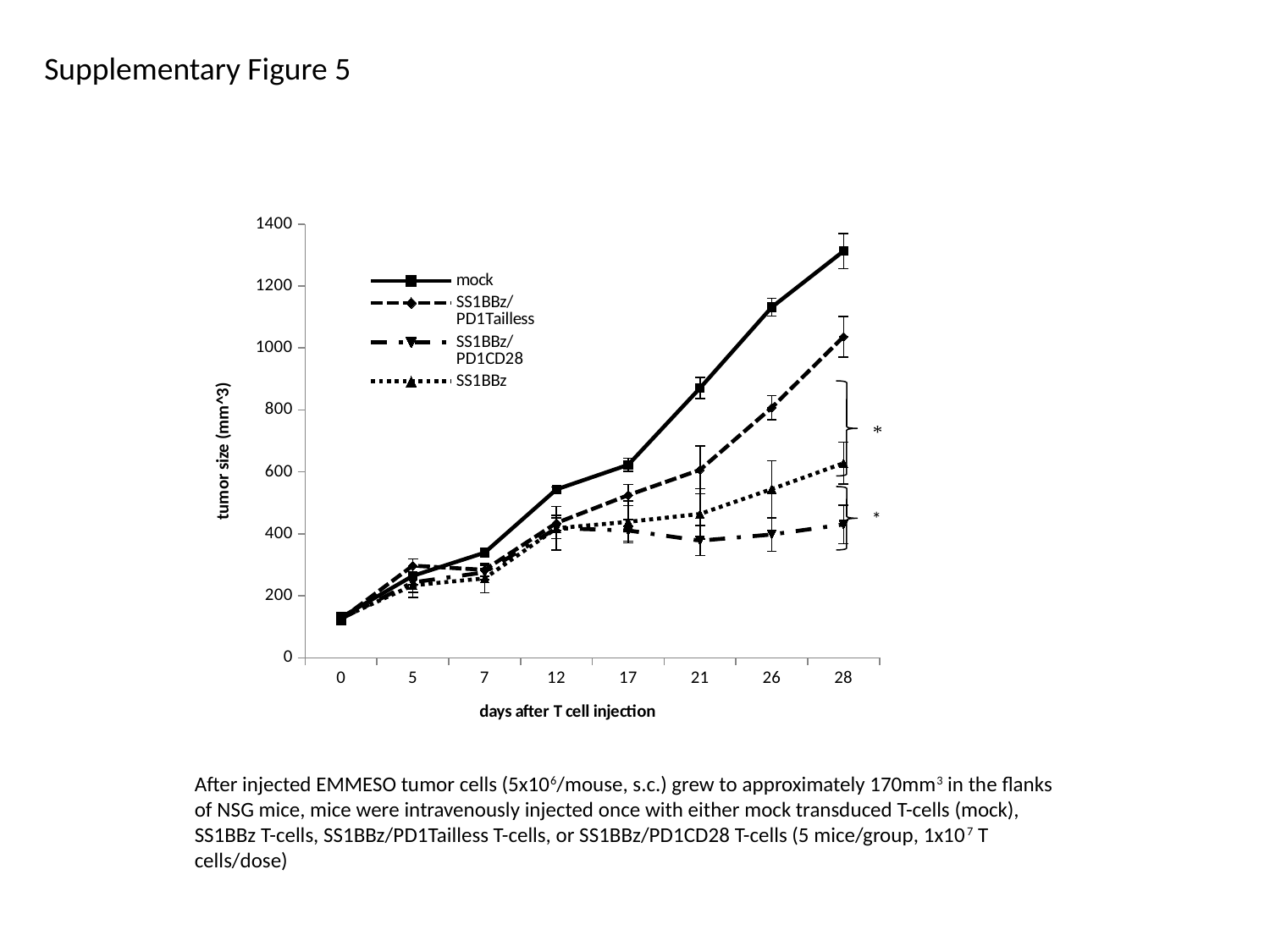
How many time points are plotted along the x axis? 8 Does the tumor size for the mock series rise or fall from day 0 to day 28? rise Which series has the highest tumor size at day 28? mock How many series does the legend list? 4 Is the tumor size for SS1BBz/PD1CD28 at day 28 greater or less than 600? less What is the title of the y axis? tumor size (mm^3) Is the tumor size for mock at day 28 greater or less than 1200? greater At day 26, which series has the larger tumor size: mock or SS1BBz/PD1Tailless? mock At day 28, which series has the larger tumor size: SS1BBz/PD1Tailless or SS1BBz? SS1BBz/PD1Tailless Which series has the lowest tumor size at day 28? SS1BBz/PD1CD28 Is the tumor size for SS1BBz/PD1Tailless at day 28 greater or less than 800? greater What kind of chart is shown on the slide? line chart